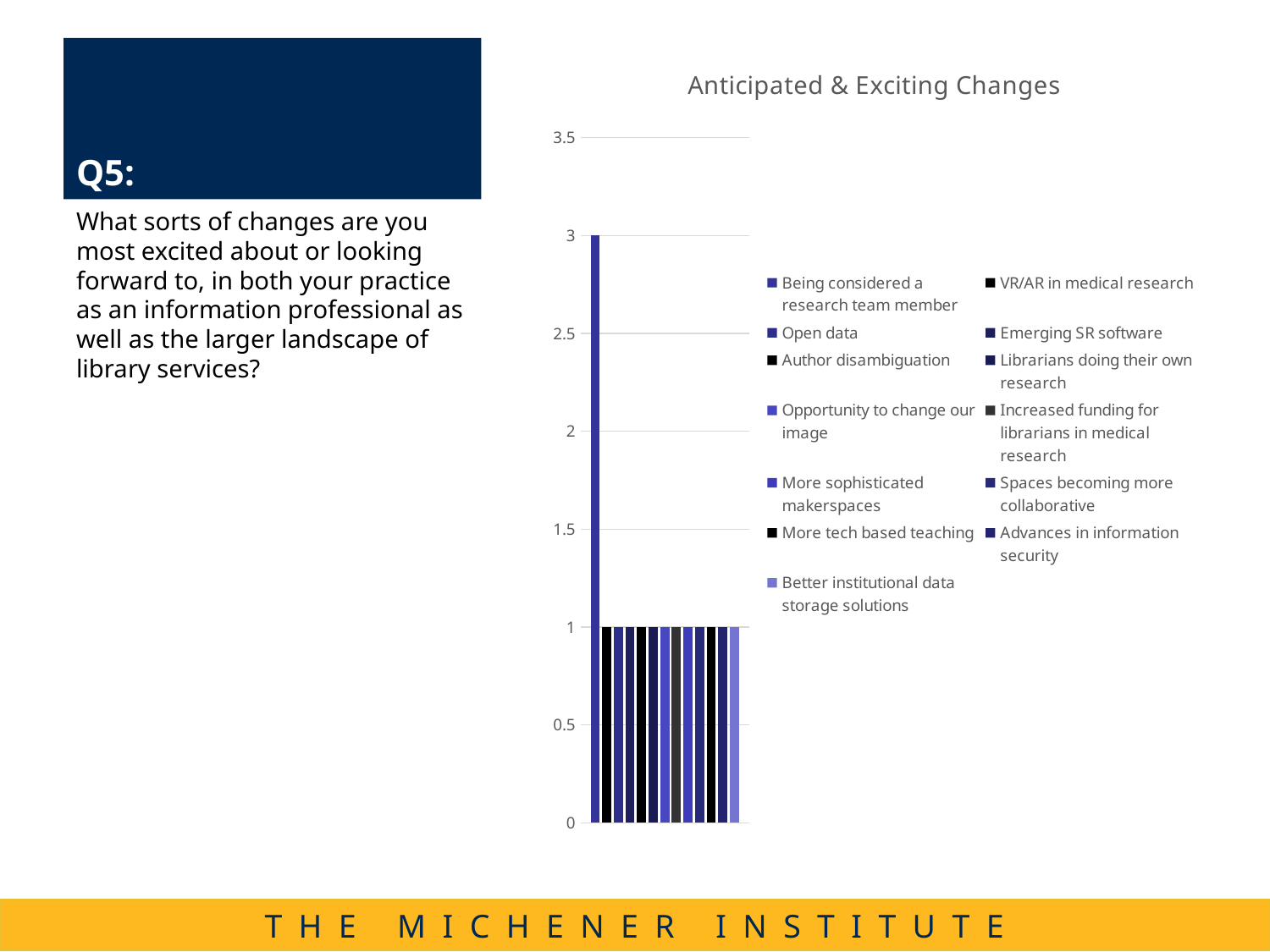
What kind of chart is shown on the slide? bar chart Is the value for Being considered a research team member greater or less than 2.5? greater What is the title of the chart? Anticipated & Exciting Changes How many bars in the chart have a value of 1? 12 What is the value for Open data? 1 What is the highest value shown on the vertical axis of the chart? 3.5 Which series has the highest value in the chart? Being considered a research team member How many series does the chart's legend list? 13 What is the difference between the value for Being considered a research team member and the value for Open data? 2 How many bars are plotted in the chart? 13 Which is larger, the value for Being considered a research team member or the value for VR/AR in medical research? Being considered a research team member What is the value of the tallest bar in the chart? 3